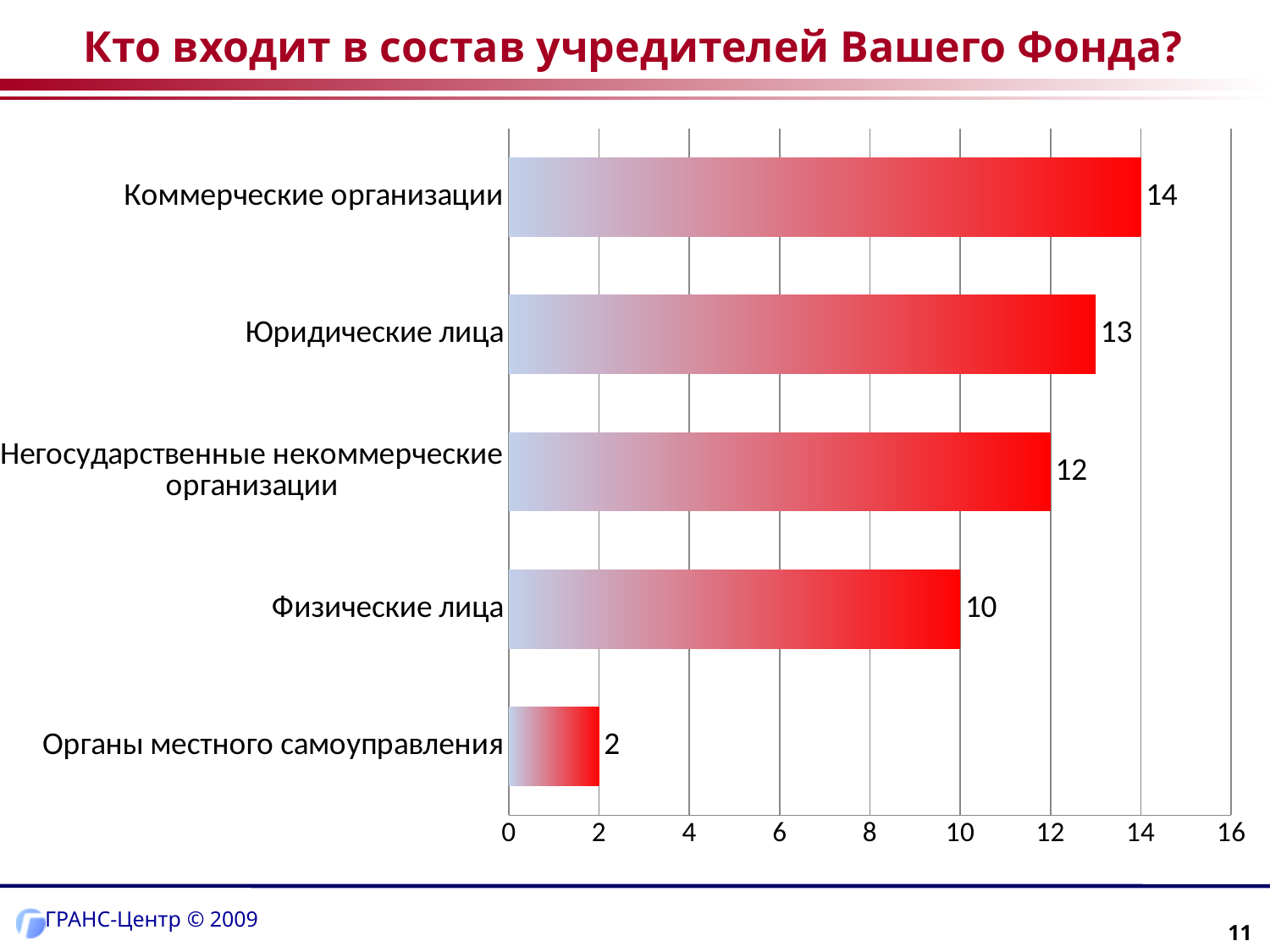
How many categories are shown in the chart? 5 What is the value for Органы местного самоуправления? 2 What is the value for Юридические лица? 13 What is the value for Физические лица? 10 Which category has the lowest value? Органы местного самоуправления Which category has the highest value? Коммерческие организации What kind of chart is shown on the slide? Bar chart Which is larger: the value for Юридические лица or the value for Физические лица? Юридические лица What is the difference between the values for Коммерческие организации and Физические лица? 4 What is the value for Негосударственные некоммерческие организации? 12 What is the value for Коммерческие организации? 14 What is the title of the slide? Кто входит в состав учредителей Вашего Фонда?